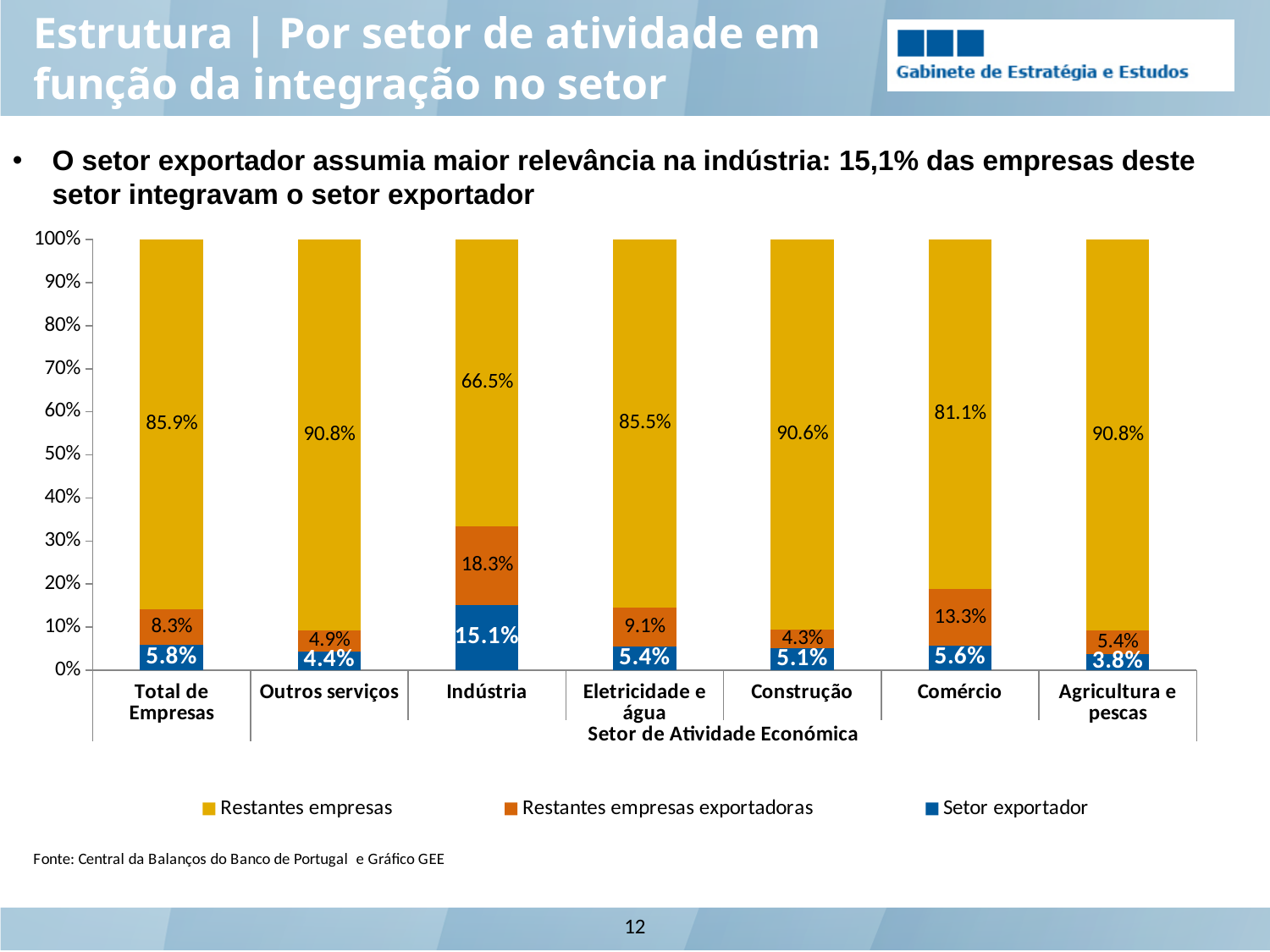
How many sectors are shown on the x axis of the chart? 7 Which sector has the highest value for the Setor exportador series? Indústria Which sector has the lowest value for the Setor exportador series? Agricultura e pescas Which is larger, the Setor exportador value for Construção or for Outros serviços? Construção What is the value of the Setor exportador series for Indústria? 15.1% What is the value of the Restantes empresas exportadoras series for Eletricidade e água? 9.1% What is the difference between the Setor exportador values for Indústria and Comércio? 9.5 percentage points What kind of chart is shown on the slide? Stacked bar chart How many series does the chart's legend list? 3 Which sector has the lowest value for the Restantes empresas series? Indústria What is the title of the x axis of the chart? Setor de Atividade Económica What is the value of the Restantes empresas series for Comércio? 81.1%